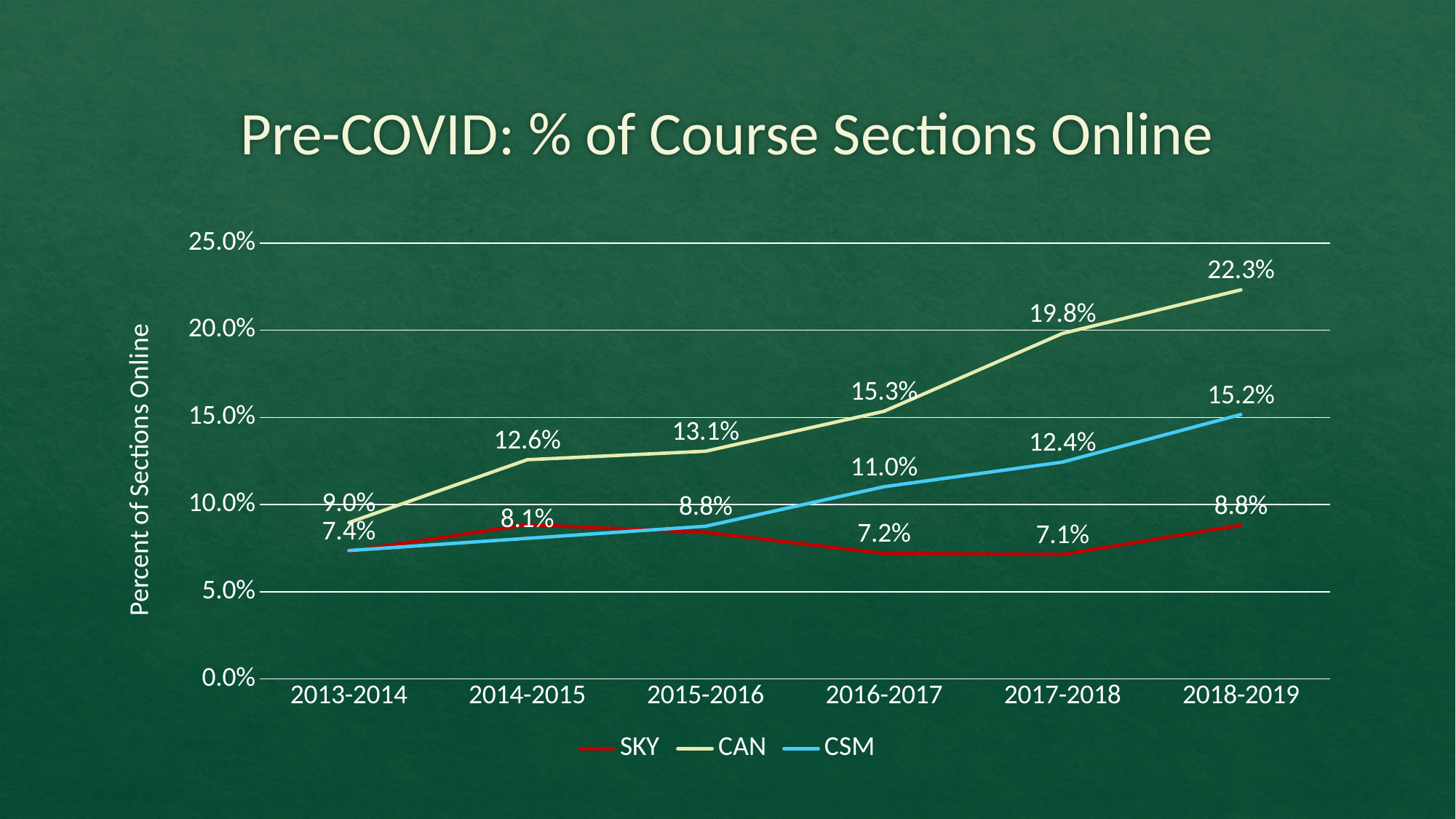
What is the value for CAN in 2017-2018? 19.8% What is the value for SKY in 2017-2018? 7.1% What is the value for CAN in 2018-2019? 22.3% What is the difference between the CAN and CSM values in 2018-2019? 7.1 percentage points Which is larger in 2016-2017, the value for CSM or the value for SKY? CSM How many series does the legend list? 3 How many academic years are shown on the x axis? 6 Which series has the highest value in 2018-2019? CAN What kind of chart is shown on the slide? Line chart Which series has the lowest value in 2017-2018? SKY What is the value for CSM in 2016-2017? 11.0% What is the value for CSM in 2013-2014? 7.4%